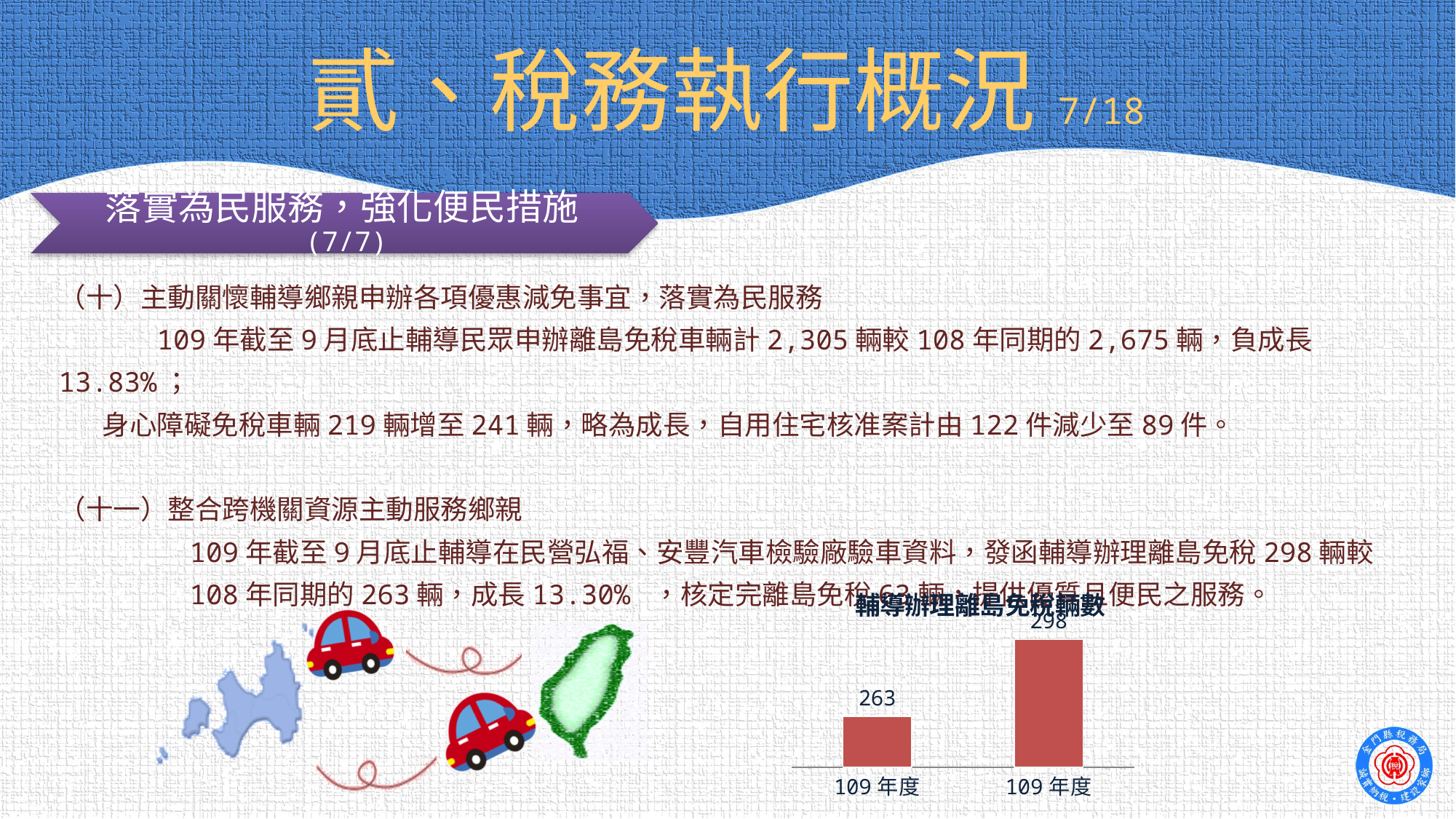
In the chart 輔導辦理離島免稅輛數, what is the difference between the right bar and the left bar? 35 In the chart 輔導辦理離島免稅輛數, what is the value of the right bar? 298 What kind of chart is shown on the slide? bar chart How many bars does the chart 輔導辦理離島免稅輛數 have? 2 In the chart 輔導辦理離島免稅輛數, what is the lowest value shown? 263 In the chart 輔導辦理離島免稅輛數, what is the value of the left bar? 263 In the chart 輔導辦理離島免稅輛數, what is the highest value shown? 298 In the chart 輔導辦理離島免稅輛數, do the values rise or fall from left to right? rise What is the title of the chart on the slide? 輔導辦理離島免稅輛數 In the chart 輔導辦理離島免稅輛數, which bar is taller, the left one or the right one? the right one What colour are the bars in the chart 輔導辦理離島免稅輛數? red